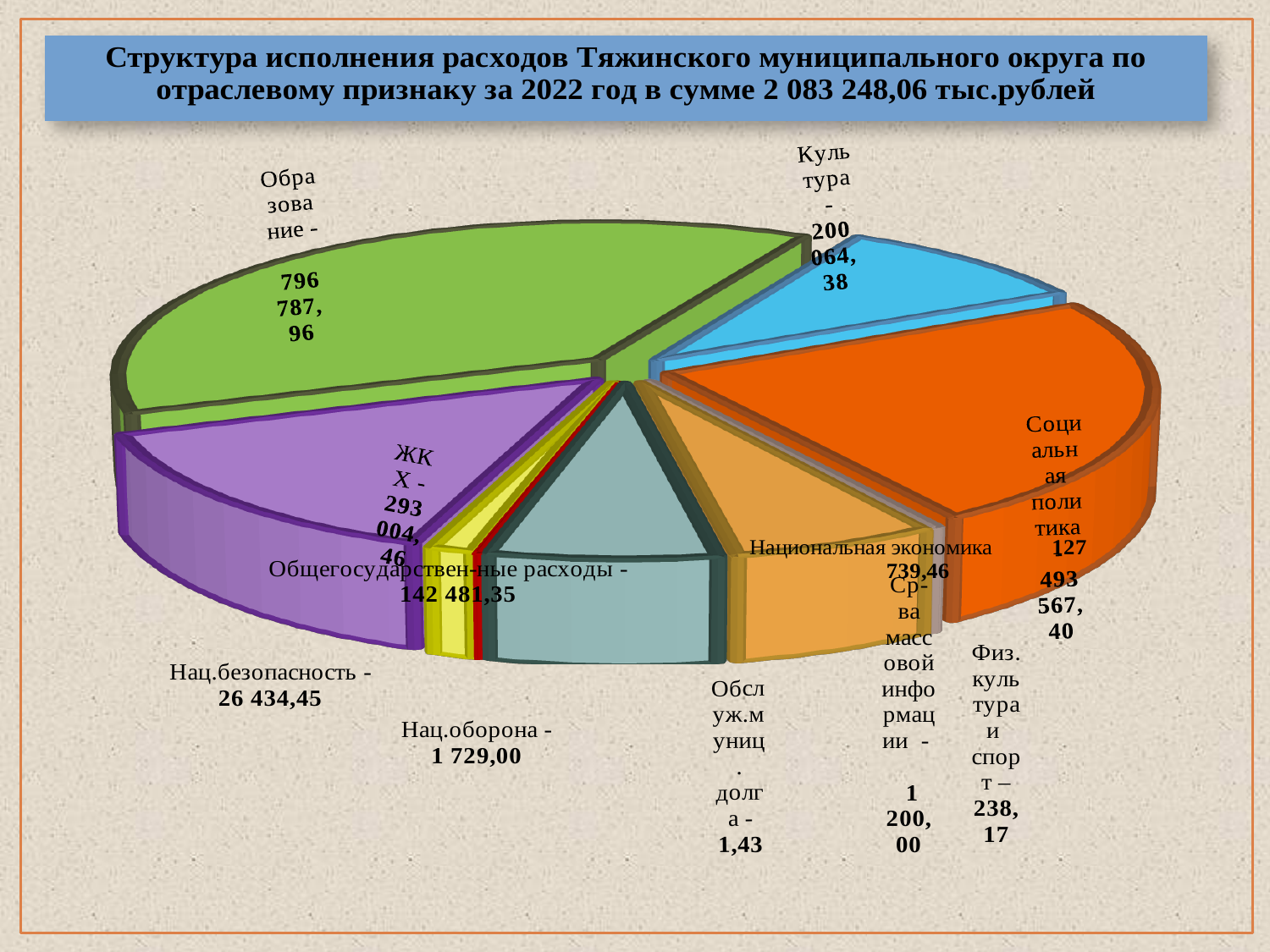
What is the value for ЖКХ? 293 004,46 What is the value for Культура? 200 064,38 What is the value for Нац.оборона? 1 729,00 What is the value for Образование? 796 787,96 According to the chart title, what is the total sum of expenditures for 2022? 2 083 248,06 тыс.рублей What is the value for Физ.культура и спорт? 238,17 What is the value for Общегосударственные расходы? 142 481,35 Which category has the smallest value? Обслуж.муниц.долга (1,43) Which category has the largest slice of the pie? Образование Which is larger, the value for ЖКХ or the value for Общегосударственные расходы? ЖКХ What kind of chart is shown on the slide? pie chart What is the difference between the values for Образование and Культура? 596 723,58